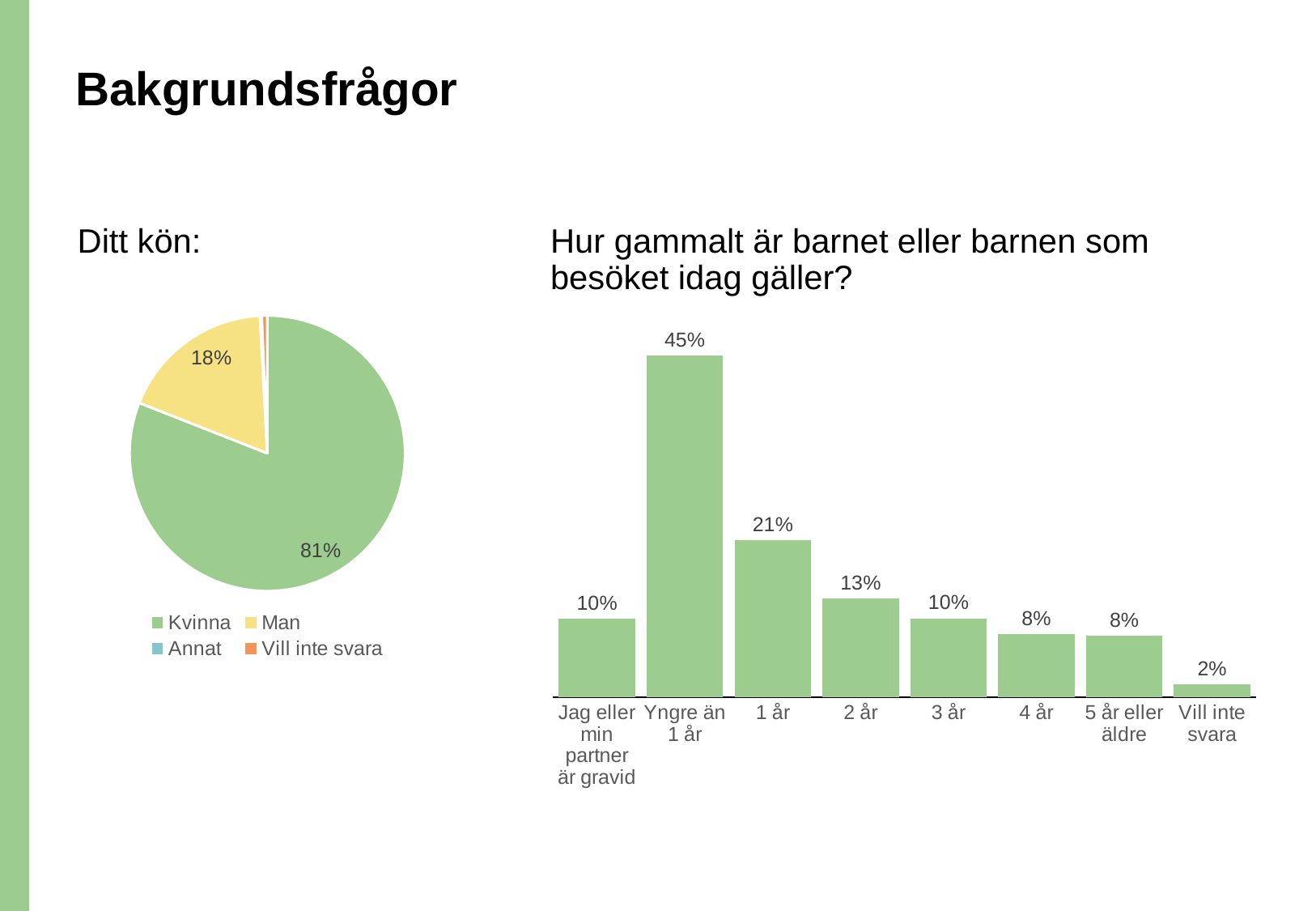
In the bar chart on the right, which is larger, the value for '3 år' or the value for '4 år'? 3 år What kind of chart is the chart on the left under 'Ditt kön:'? Pie chart In the pie chart 'Ditt kön:', what share is labelled for Man? 18% In the bar chart on the right, what is the value for '2 år'? 13% What kind of chart is the chart on the right under 'Hur gammalt är barnet eller barnen som besöket idag gäller?'? Bar chart In the pie chart 'Ditt kön:', how many entries does the legend list? 4 In the pie chart 'Ditt kön:', what share is labelled for Kvinna? 81% In the bar chart on the right, which category has the lowest value? Vill inte svara In the bar chart on the right, what is the value for 'Yngre än 1 år'? 45% In the bar chart on the right, how many categories are shown on the x axis? 8 In the pie chart 'Ditt kön:', which category has the largest slice? Kvinna In the bar chart on the right, what is the difference between the values for 'Yngre än 1 år' and '1 år'? 24%